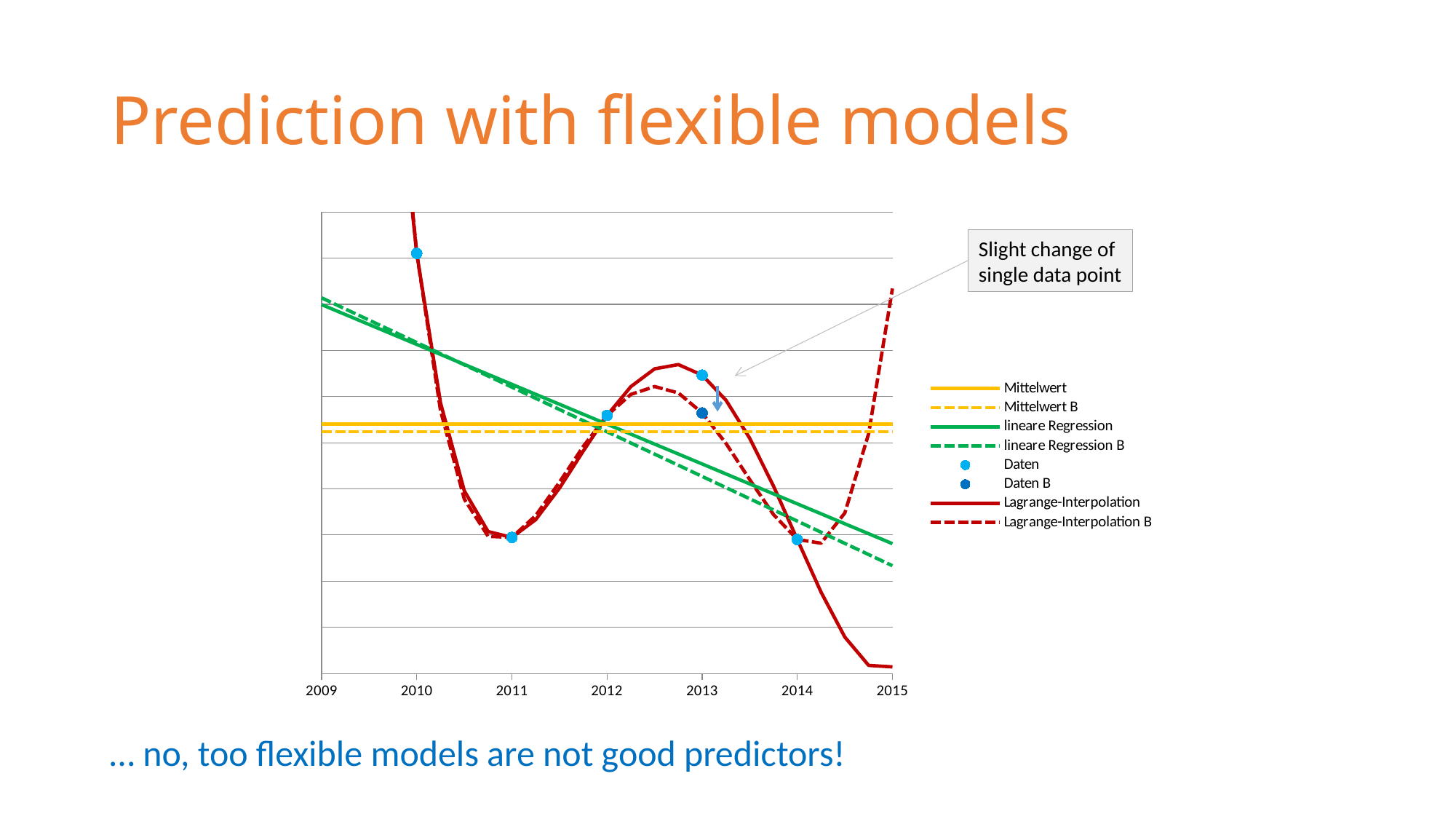
What colour is the Lagrange-Interpolation line? red How many Daten data points are plotted on the chart? 5 Which year has the highest Daten value? 2010 Which is larger, the Daten value for 2012 or for 2013? 2013 Does the Mittelwert line rise, fall or stay flat across the x axis? stay flat In which year does the Daten B point differ visibly from the Daten point? 2013 Does the lineare Regression line rise or fall from 2009 to 2015? fall What kind of chart is shown on the slide? line chart Which is larger, the Daten value for 2010 or for 2013? 2010 How many year labels are shown on the x axis? 7 How many series does the legend list? 8